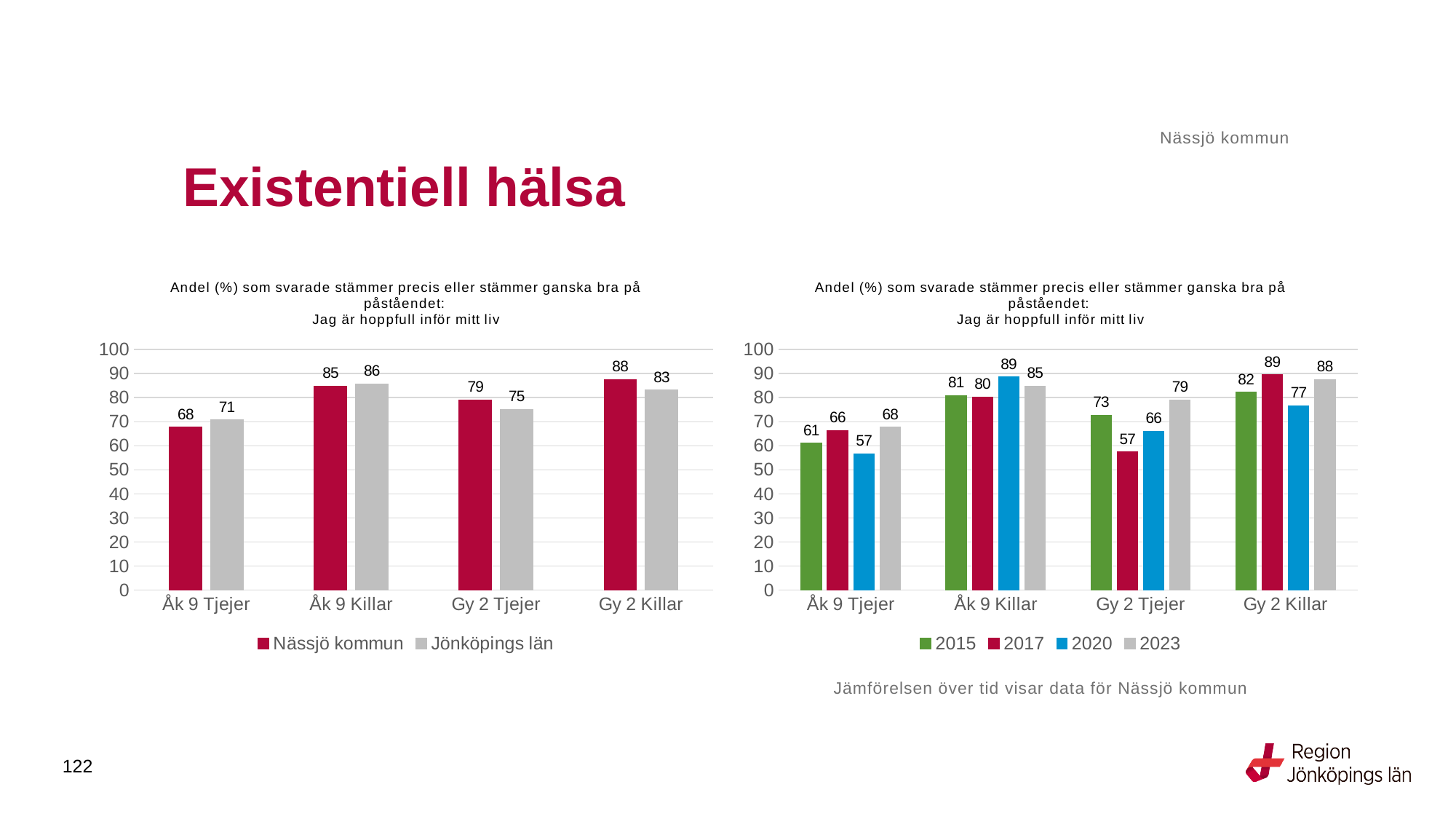
In the right chart, what is the value for 2020 for Åk 9 Killar? 89 In the left chart, what is the difference between Nässjö kommun and Jönköpings län for Gy 2 Tjejer? 4 In the right chart, which year has the lowest value for Åk 9 Tjejer? 2020 In the right chart, how many series does the legend list? 4 In the left chart, what is the value for Nässjö kommun for Åk 9 Tjejer? 68 In the right chart, is the value for 2015 for Gy 2 Killar larger or the value for 2023 for Gy 2 Killar? 2023 In the left chart, how many series does the legend list? 2 In the left chart, which category has the highest value for Nässjö kommun? Gy 2 Killar What type of chart is the left chart? Bar chart In the left chart, what is the value for Jönköpings län for Gy 2 Killar? 83 In the right chart, what is the value for 2017 for Gy 2 Tjejer? 57 In the right chart, how many categories are shown on the x axis? 4